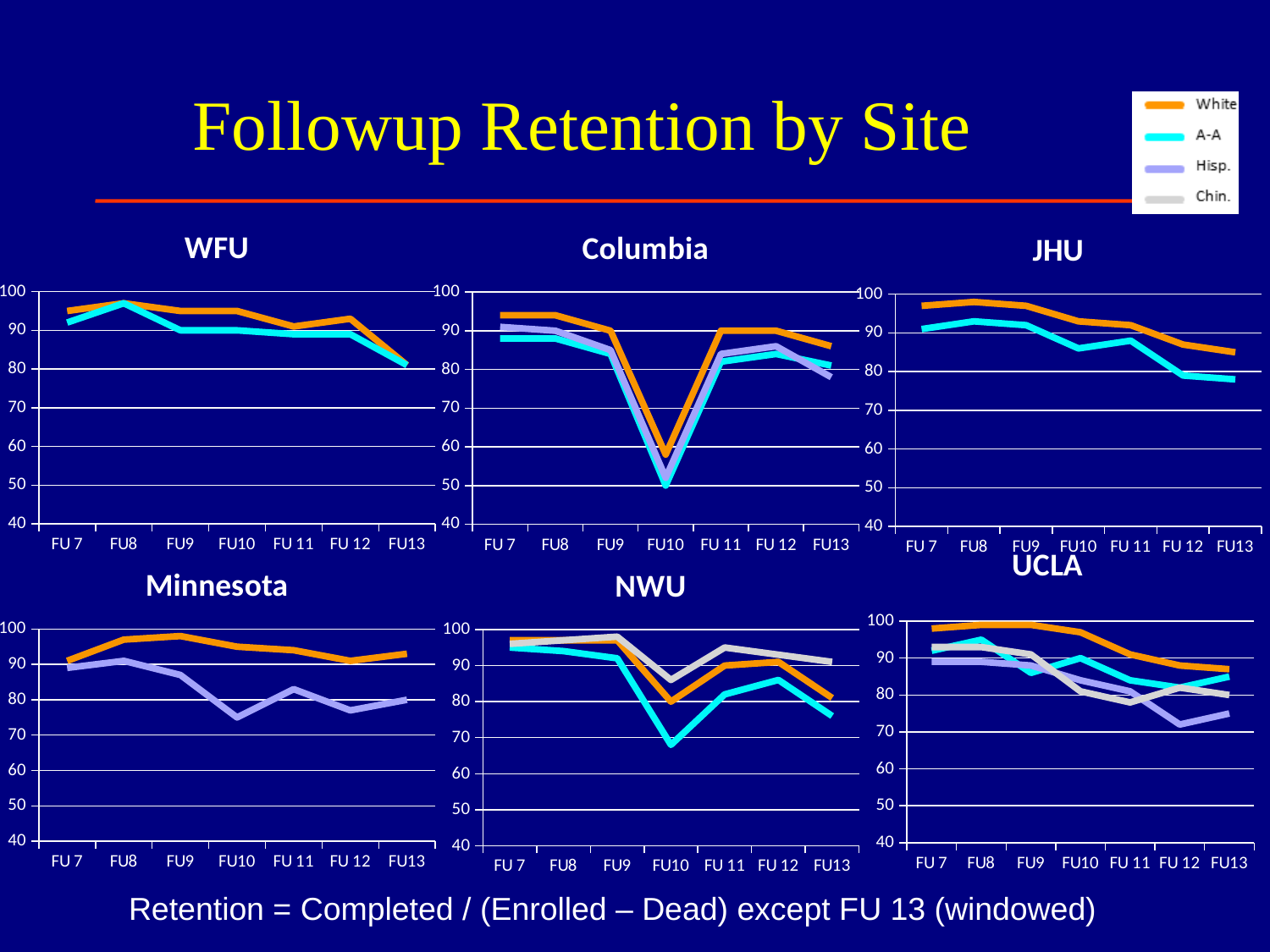
In the WFU chart, does the A-A line rise or fall from FU8 to FU13? fall In the Columbia chart, at which follow-up is the A-A value lowest? FU10 In the Minnesota chart, which series is higher at FU10, White or Hisp.? White In the UCLA chart, is the Hisp. value at FU 12 greater or less than 80? less In the JHU chart, is the White value at FU 7 greater or less than 90? greater How many follow-up points are plotted along the x axis of the Columbia chart? 7 What kind of chart is used for the WFU panel? line chart How many series does the legend in the top right list? 4 In the Minnesota chart, is the Hisp. value at FU10 greater or less than 80? less In the Columbia chart, which series has the lowest value at FU10? A-A